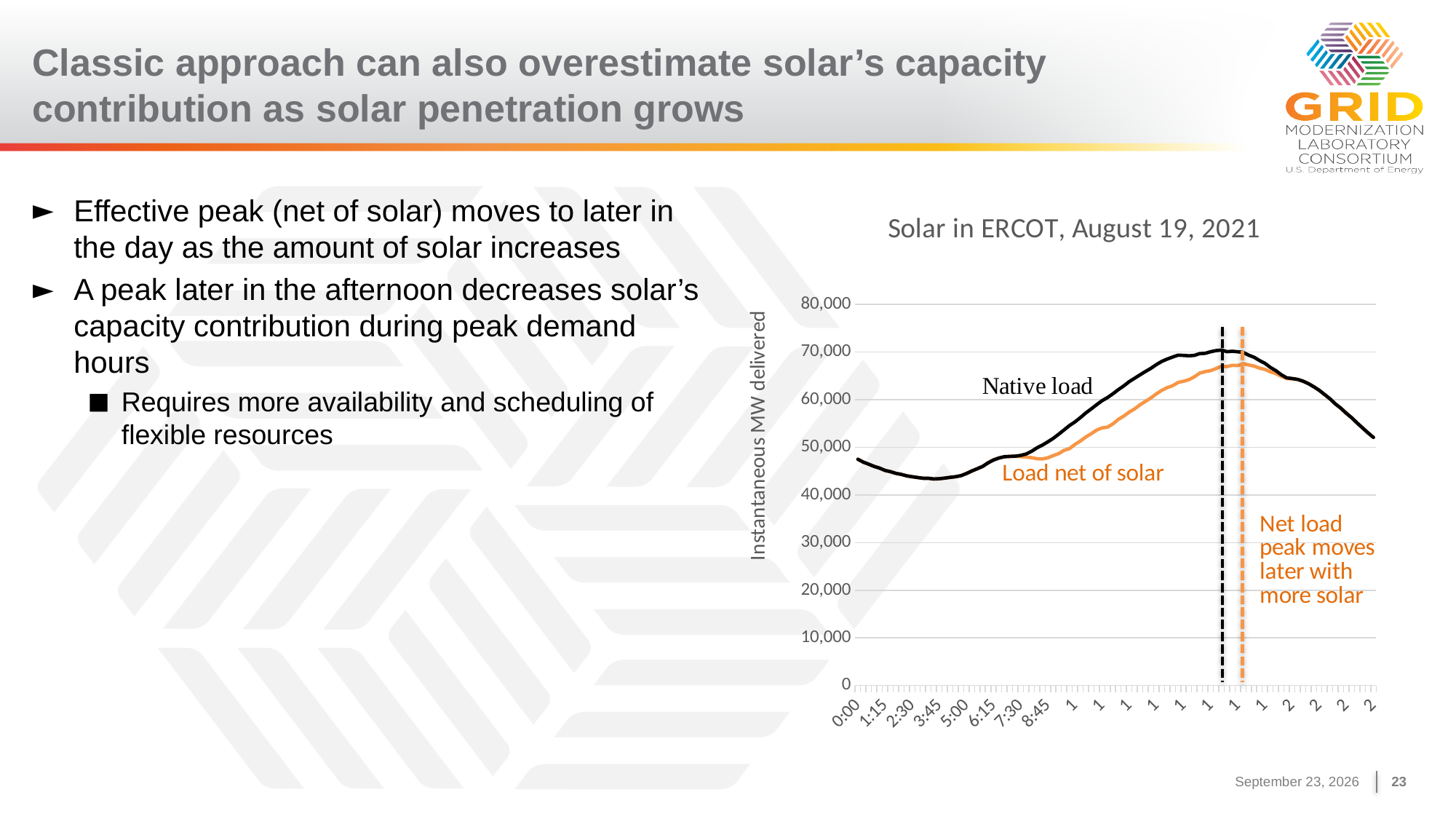
Is the peak value of the Load net of solar line greater or less than 60,000? greater What is the title of the chart? Solar in ERCOT, August 19, 2021 Does the Native load line rise or fall between 0:00 and 3:45? fall Is the peak value of the Native load line greater or less than 60,000? greater Which series reaches its peak later in the day, Native load or Load net of solar? Load net of solar Which series reaches the higher peak, Native load or Load net of solar? Native load Is the Native load value at 2:30 greater or less than 50,000? less How many data series are plotted on the chart? 2 What kind of chart is shown on the slide? line chart What is the label of the vertical axis of the chart? Instantaneous MW delivered